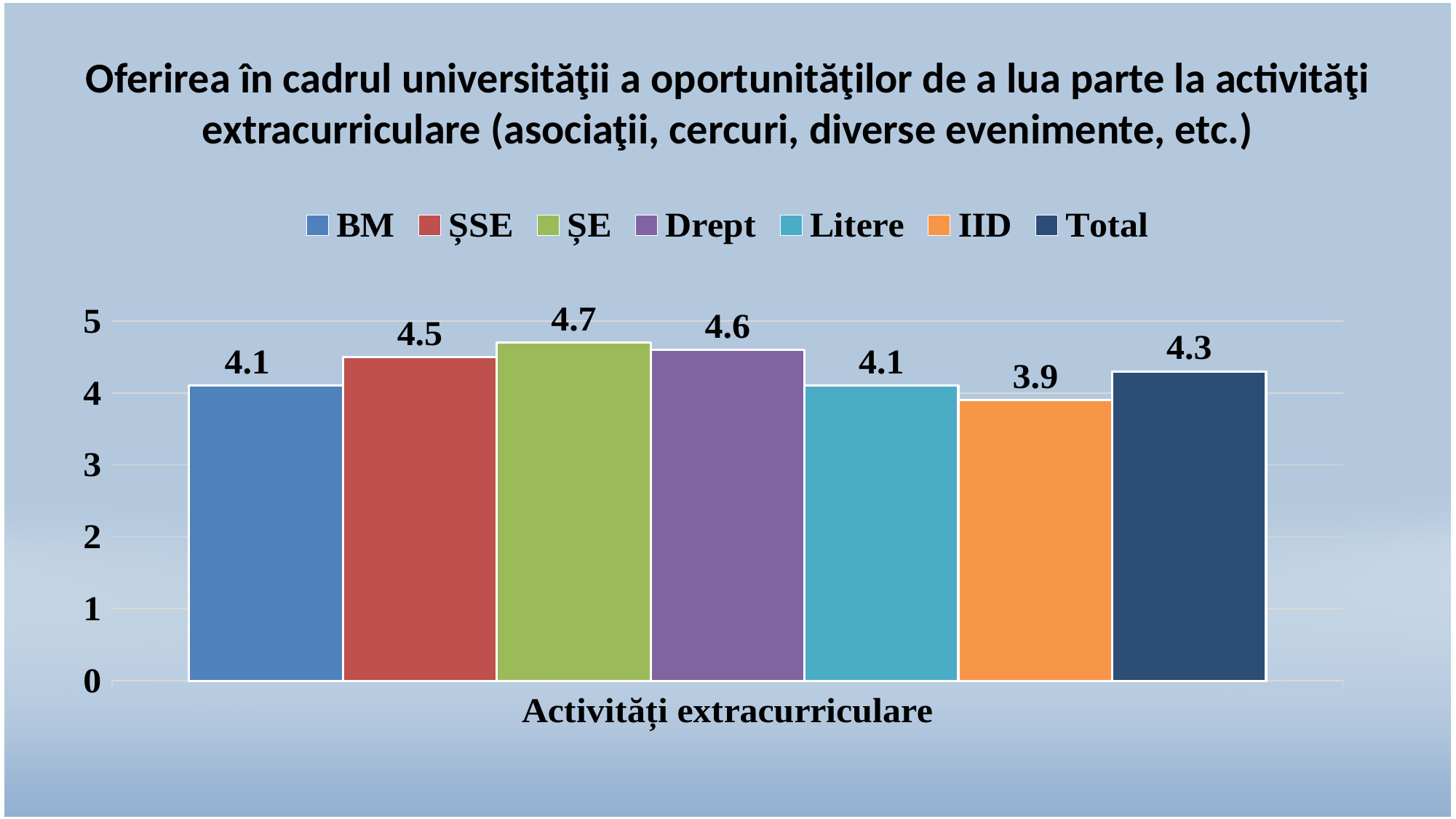
Which series has the highest value? ȘE Which series has the lowest value? IID Which is larger, the value for ȘSE or the value for Litere? ȘSE What is the difference between the values for ȘE and IID? 0.8 What is the label on the x axis of the chart? Activități extracurriculare What kind of chart is shown on the slide? Bar chart What is the value for Drept? 4.6 What is the value for ȘE? 4.7 What is the difference between the values for ȘSE and BM? 0.4 What is the value for IID? 3.9 What is the value for Total? 4.3 How many series does the legend list? 7